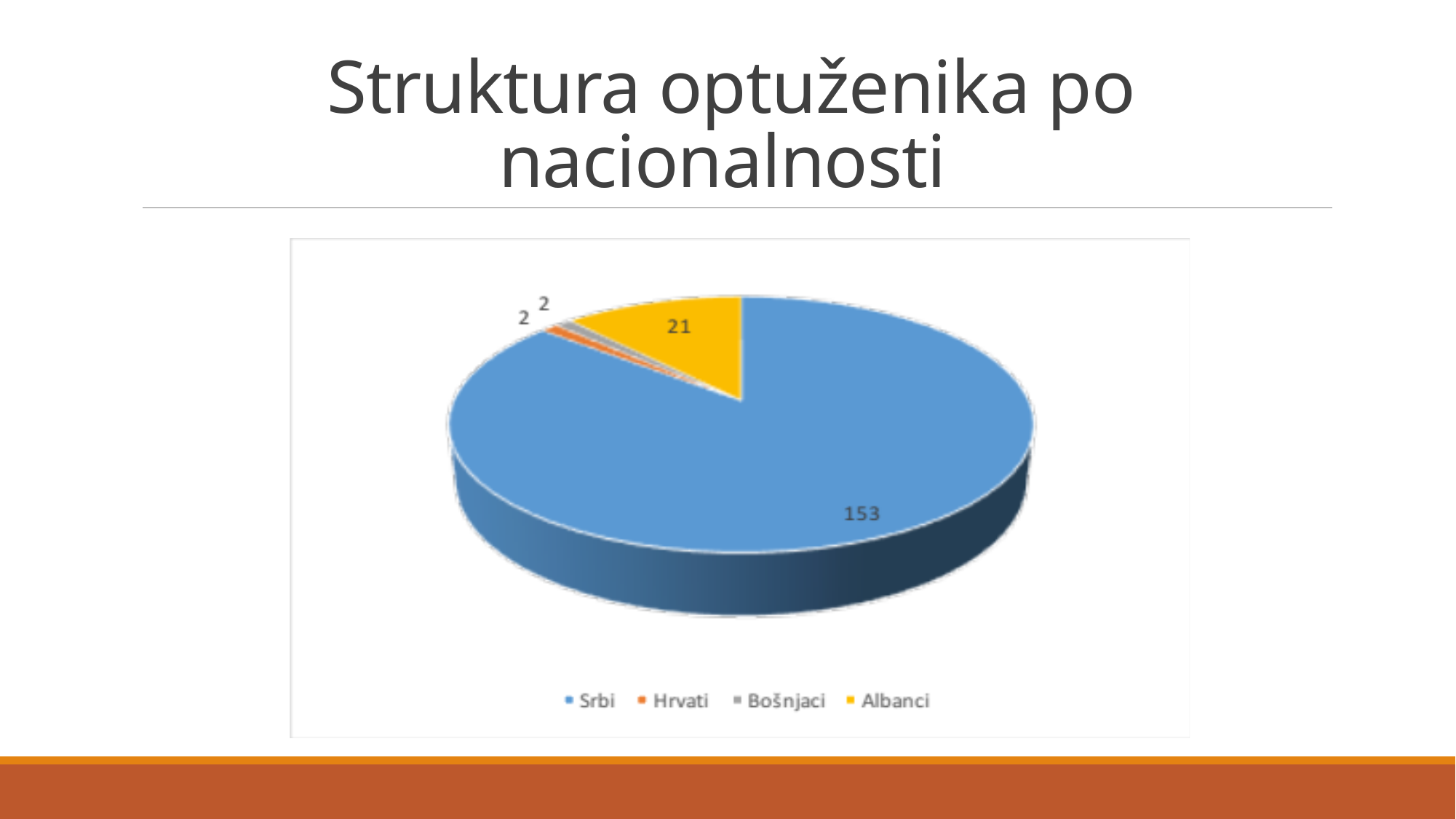
How many categories are shown in the pie chart? 4 What is the value for Srbi in the pie chart? 153 What is the value for Hrvati in the pie chart? 2 What is the difference between the values for Albanci and Bošnjaci? 19 What colour is the slice for Albanci in the pie chart? Yellow What is the difference between the values for Srbi and Albanci? 132 What is the total of all the values in the pie chart? 178 What is the title of the slide containing the chart? Struktura optuženika po nacionalnosti Which category has the largest slice of the pie chart? Srbi Which is larger, the value for Albanci or the value for Hrvati? Albanci What kind of chart is shown on the slide? Pie chart What is the value for Albanci in the pie chart? 21